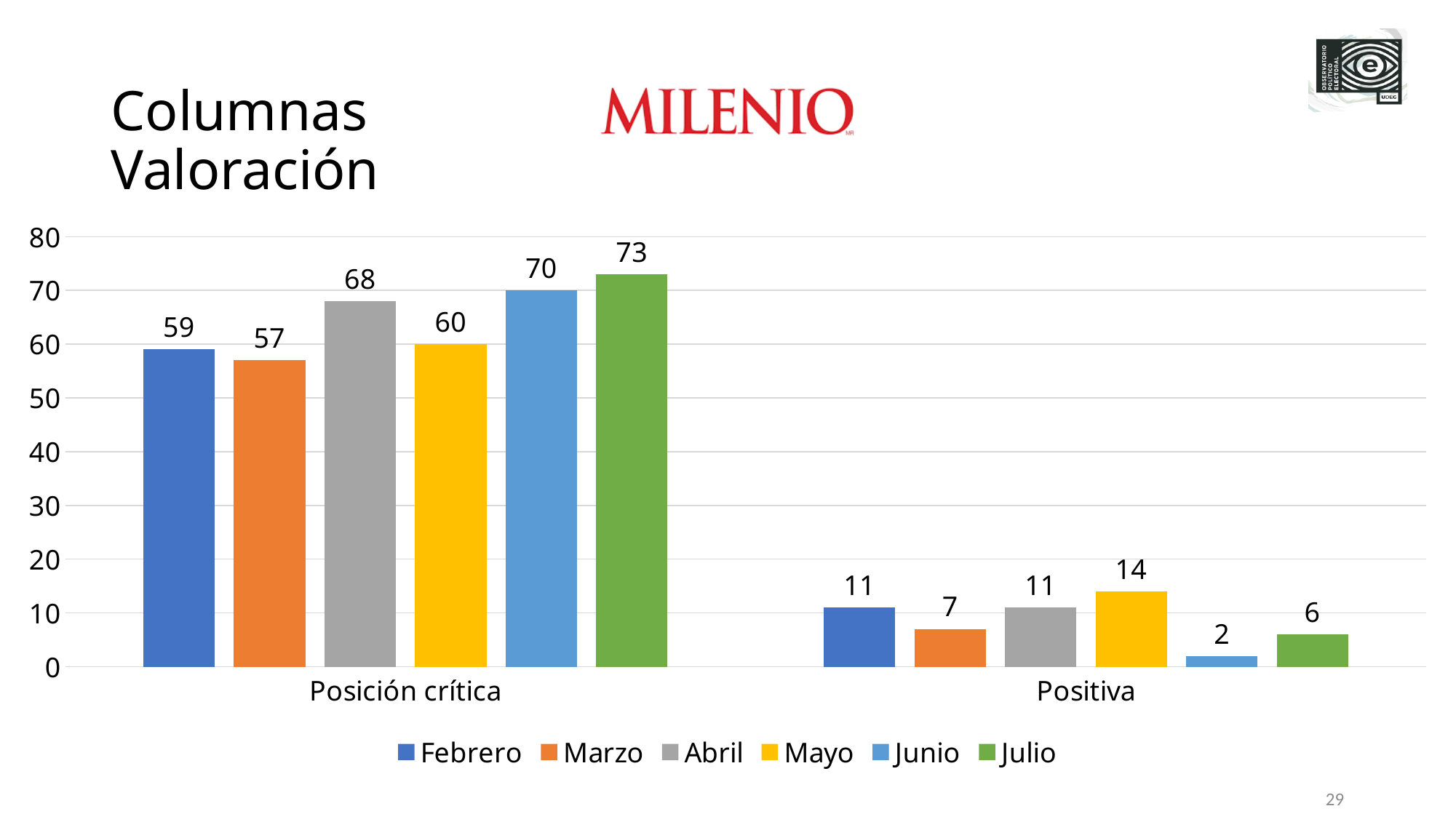
Which is larger in the Positiva category, Marzo or Julio? Marzo What is the value for Marzo in the Posición crítica category? 57 What colour represents Mayo in the chart? Yellow Which month has the lowest value in the Positiva category? Junio What is the difference between the Julio and Febrero values in the Posición crítica category? 14 What is the value for Mayo in the Positiva category? 14 Which month has the highest value in the Posición crítica category? Julio What kind of chart is shown on the slide? Bar chart How many series does the legend list? 6 How many categories are shown on the x axis? 2 Is the value for Abril in the Posición crítica category greater or less than 60? greater What is the value for Julio in the Posición crítica category? 73